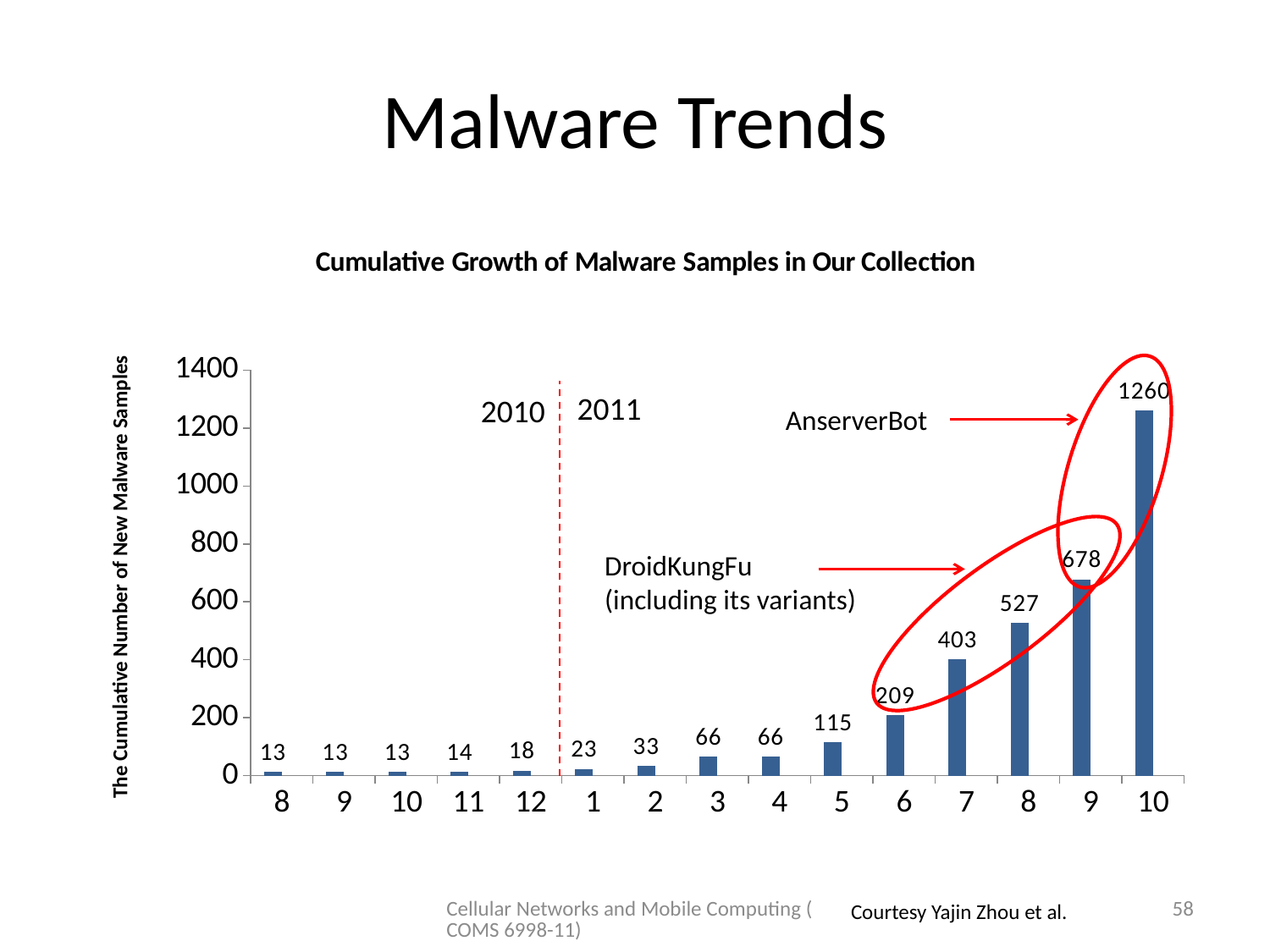
What is the difference between the values for month 7 of 2011 and month 6 of 2011? 194 Do the values generally rise or fall from left to right along the x axis? rise How many bars are plotted in the chart? 15 What kind of chart is shown on the slide? bar chart Which is larger, the value for month 8 of 2011 or the value for month 5 of 2011? month 8 of 2011 Which malware is labelled as responsible for the jump to 1260 in month 10 of 2011? AnserverBot What is the cumulative number of new malware samples for month 12 of 2010? 18 Which month has the highest cumulative number of new malware samples? 10 (2011) What is the title of the chart? Cumulative Growth of Malware Samples in Our Collection What is the difference between the values for month 10 of 2011 and month 9 of 2011? 582 What is the cumulative number of new malware samples for month 10 of 2011? 1260 What is the cumulative number of new malware samples for month 6 of 2011? 209